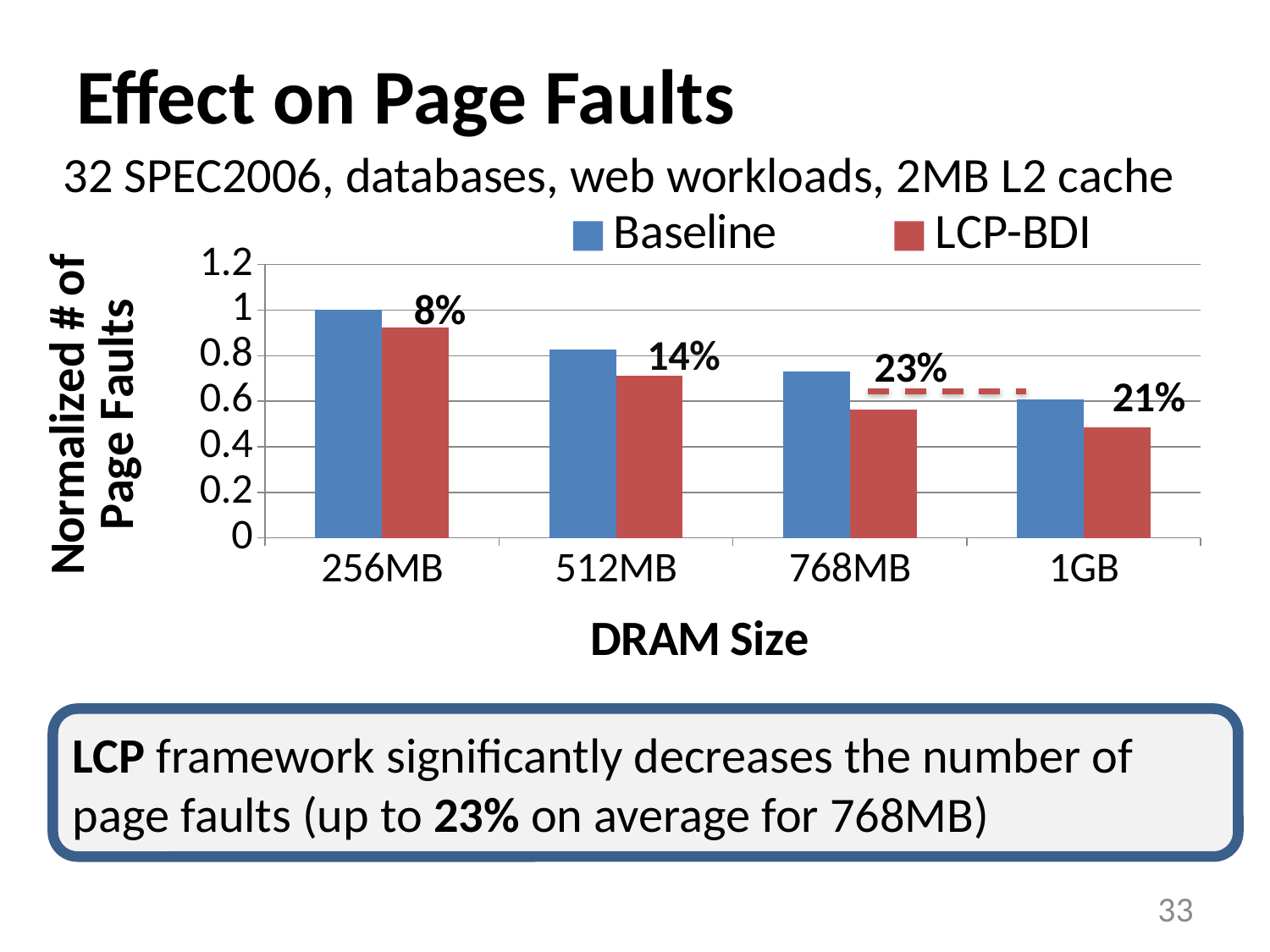
Is the LCP-BDI value for 1GB greater or less than 0.6? less Is the Baseline value for 768MB greater or less than 0.8? less What percentage reduction is labeled above the 768MB bars? 23% At 768MB, which series has the higher normalized number of page faults, Baseline or LCP-BDI? Baseline Which DRAM size has the largest labeled percentage reduction? 768MB What percentage reduction is labeled for 256MB? 8% Do the Baseline values rise or fall as DRAM size increases from 256MB to 1GB? fall What is the normalized number of page faults for Baseline at 256MB? 1 How many DRAM size categories are shown on the x axis? 4 How many series does the legend list? 2 What kind of chart is shown on the slide? bar chart Which DRAM size has the smallest labeled percentage reduction? 256MB